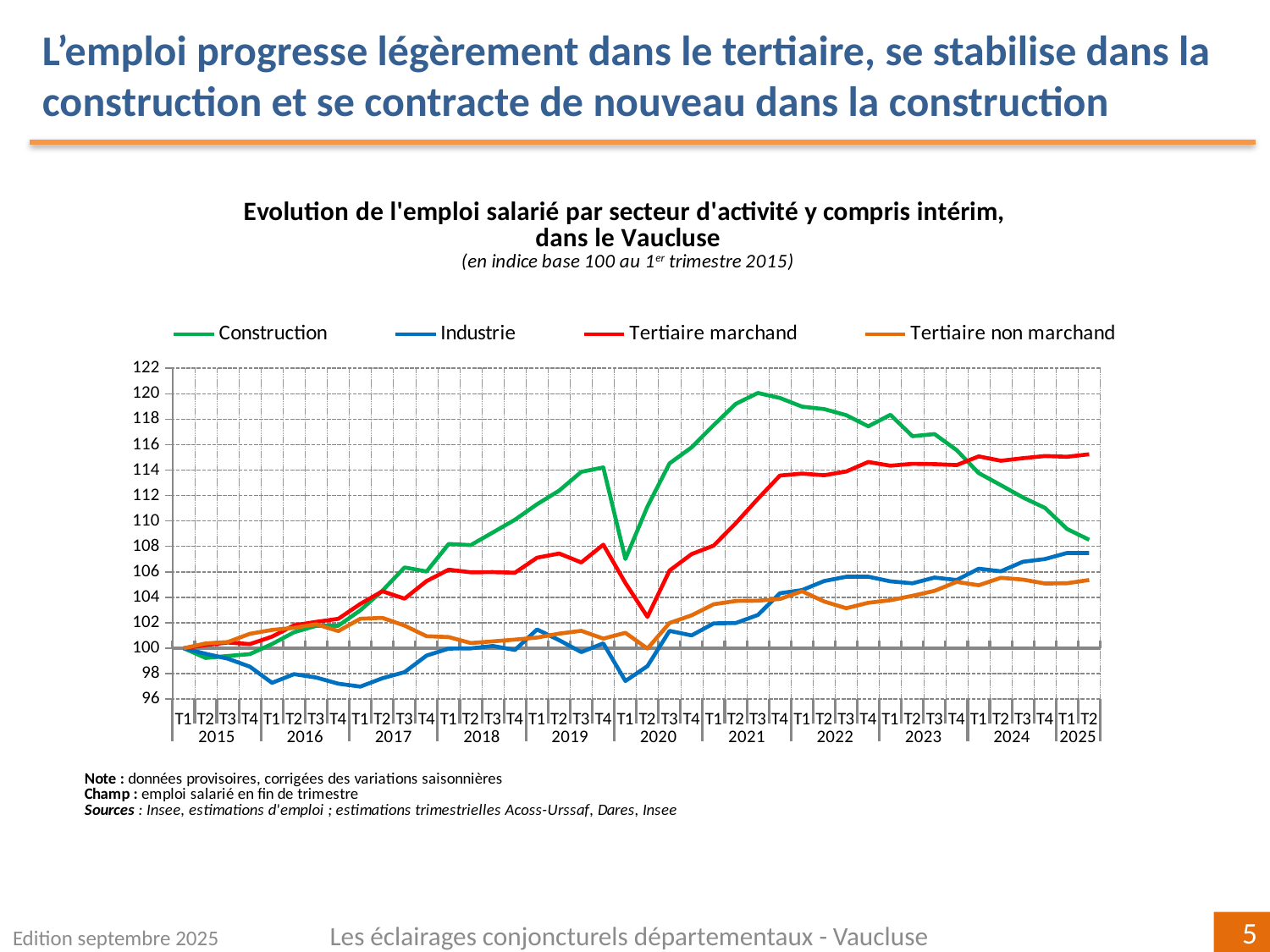
How many series does the legend list? 4 Is the value for Construction at T3 2021 greater or less than 118? greater Does the Construction series rise or fall between T1 2023 and T2 2025? fall Is the value for Industrie at T1 2017 greater or less than 98? less What colour is the Industrie line in the chart? blue Which series has the highest value at T2 2025? Tertiaire marchand At T2 2025, which is larger: Tertiaire marchand or Construction? Tertiaire marchand Is the value for Tertiaire marchand at T2 2020 greater or less than 104? less What kind of chart is shown on the slide? line chart Which series reaches the highest value anywhere on the chart? Construction Which series falls to the lowest value anywhere on the chart? Industrie Which series has the lowest value at T2 2025? Tertiaire non marchand